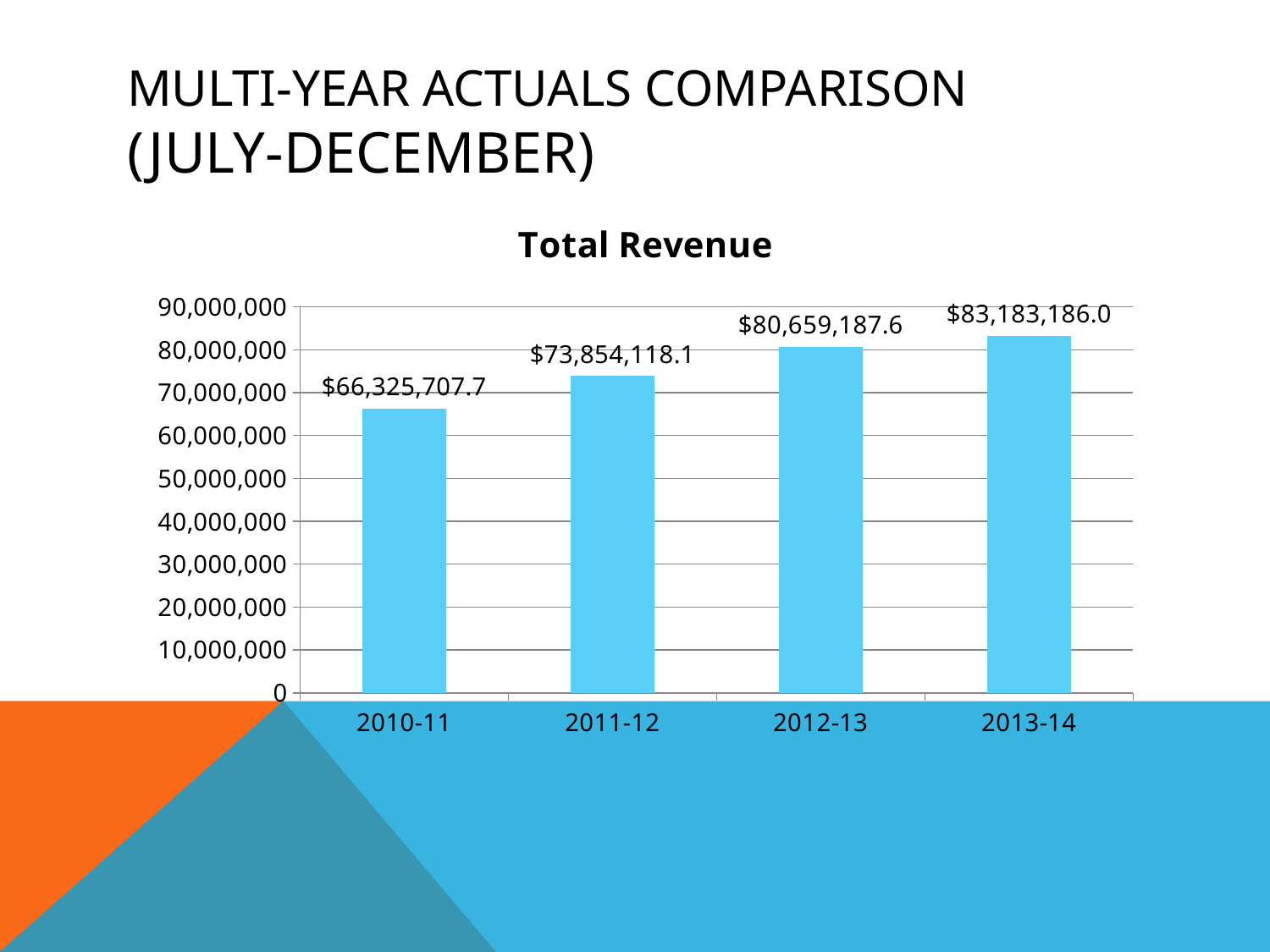
What is the Total Revenue for 2012-13? $80,659,187.6 Is the Total Revenue for 2011-12 greater or less than 70,000,000? greater How many years are shown on the Total Revenue chart? 4 Which year has the lowest Total Revenue? 2010-11 What is the Total Revenue for 2013-14? $83,183,186.0 What is the difference in Total Revenue between 2011-12 and 2010-11? $7,528,410.4 Does Total Revenue rise or fall from 2010-11 to 2013-14? Rises What is the Total Revenue for 2010-11? $66,325,707.7 What kind of chart is used to show Total Revenue? Bar chart What is the difference in Total Revenue between 2013-14 and 2012-13? $2,523,998.4 Which year has the highest Total Revenue? 2013-14 Which year has the larger Total Revenue, 2011-12 or 2012-13? 2012-13